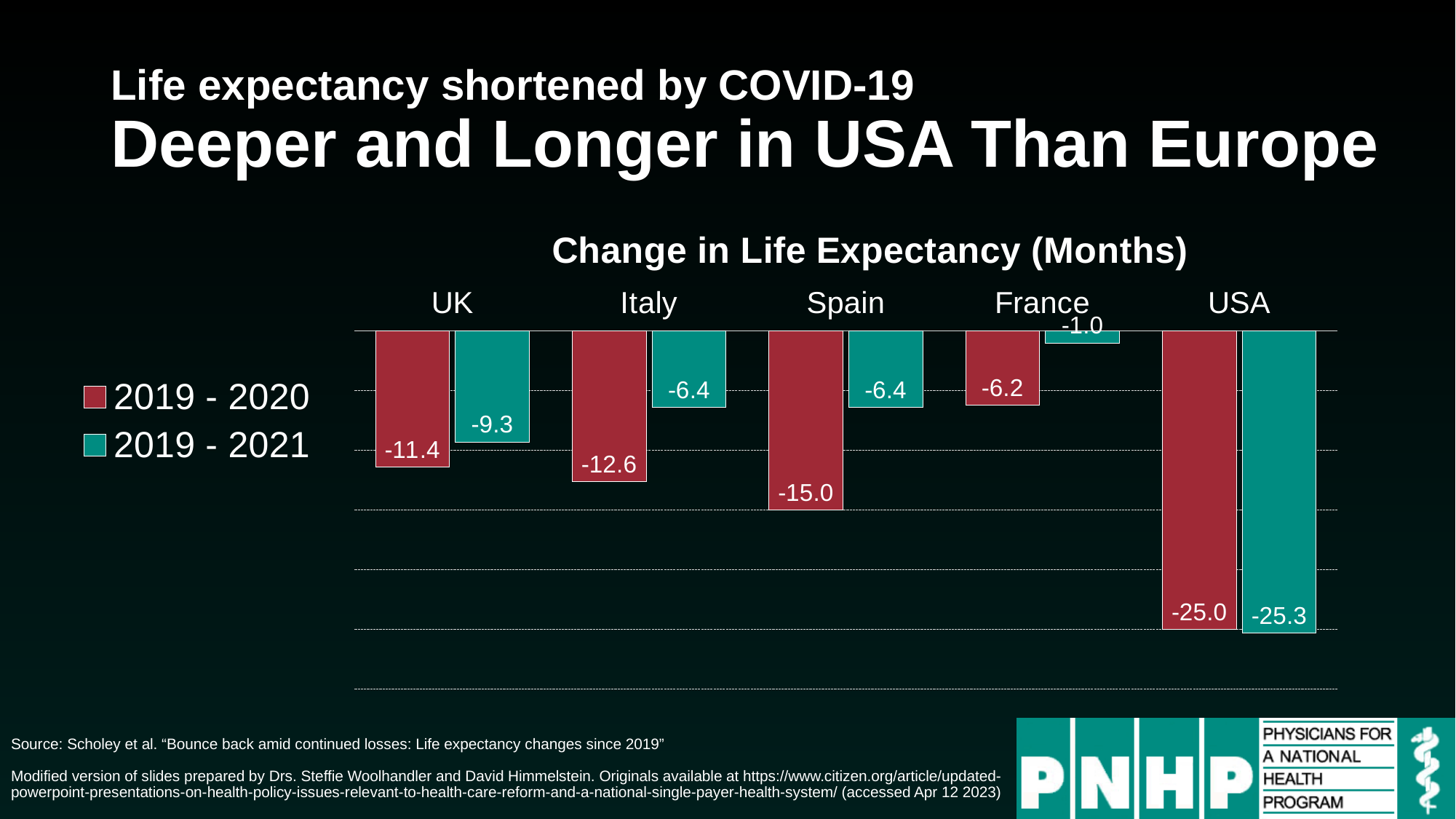
What is the 2019 - 2020 change in life expectancy for the UK? -11.4 Which is the larger decline for Spain: 2019 - 2020 or 2019 - 2021? 2019 - 2020 Which country has the smallest decline in life expectancy for 2019 - 2020? France What is the title of the chart? Change in Life Expectancy (Months) How many series does the legend list? 2 What is the 2019 - 2020 change in life expectancy for Spain? -15.0 Which country has the largest decline in life expectancy for 2019 - 2021? USA What type of chart is shown on the slide? Bar chart What is the 2019 - 2021 change in life expectancy for France? -1.0 What is the 2019 - 2021 change in life expectancy for the USA? -25.3 What is the difference between the 2019 - 2020 and 2019 - 2021 values for Italy? 6.2 How many countries are shown in the chart? 5